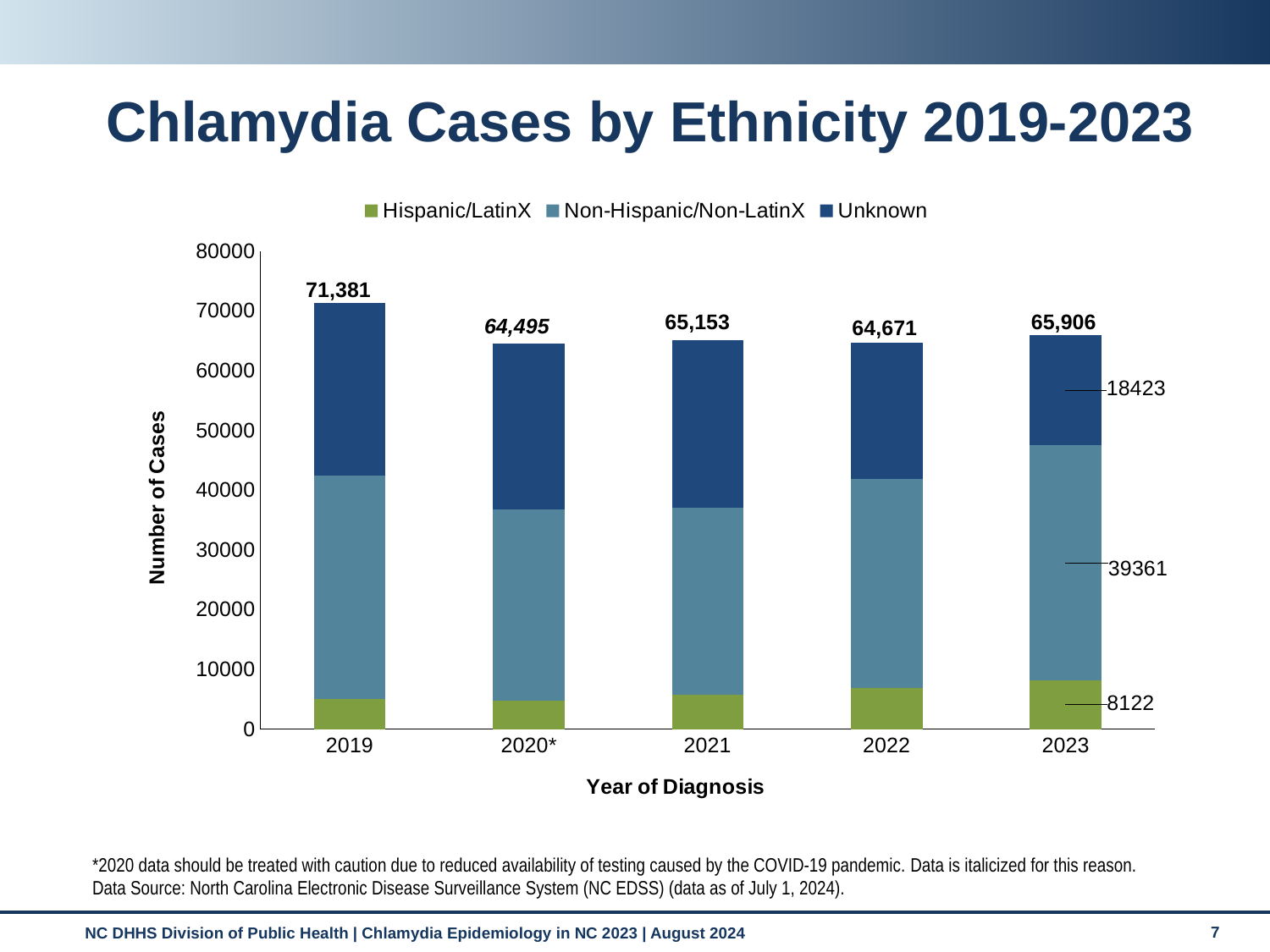
How many series does the legend list? 3 Which year has the lowest total number of cases? 2020* Which year has the highest total number of cases? 2019 What is the total number of chlamydia cases shown for 2019? 71,381 What kind of chart is shown on the slide? Stacked bar chart What is the difference between the total cases in 2019 and 2020*? 6,886 Which year has a larger total number of cases, 2021 or 2022? 2021 What is the Unknown value shown for 2023? 18423 How many years are shown on the x axis? 5 Is the Hispanic/LatinX value for 2019 greater or less than 10000? less What is the Non-Hispanic/Non-LatinX value shown for 2023? 39361 What is the Hispanic/LatinX value shown for 2023? 8122